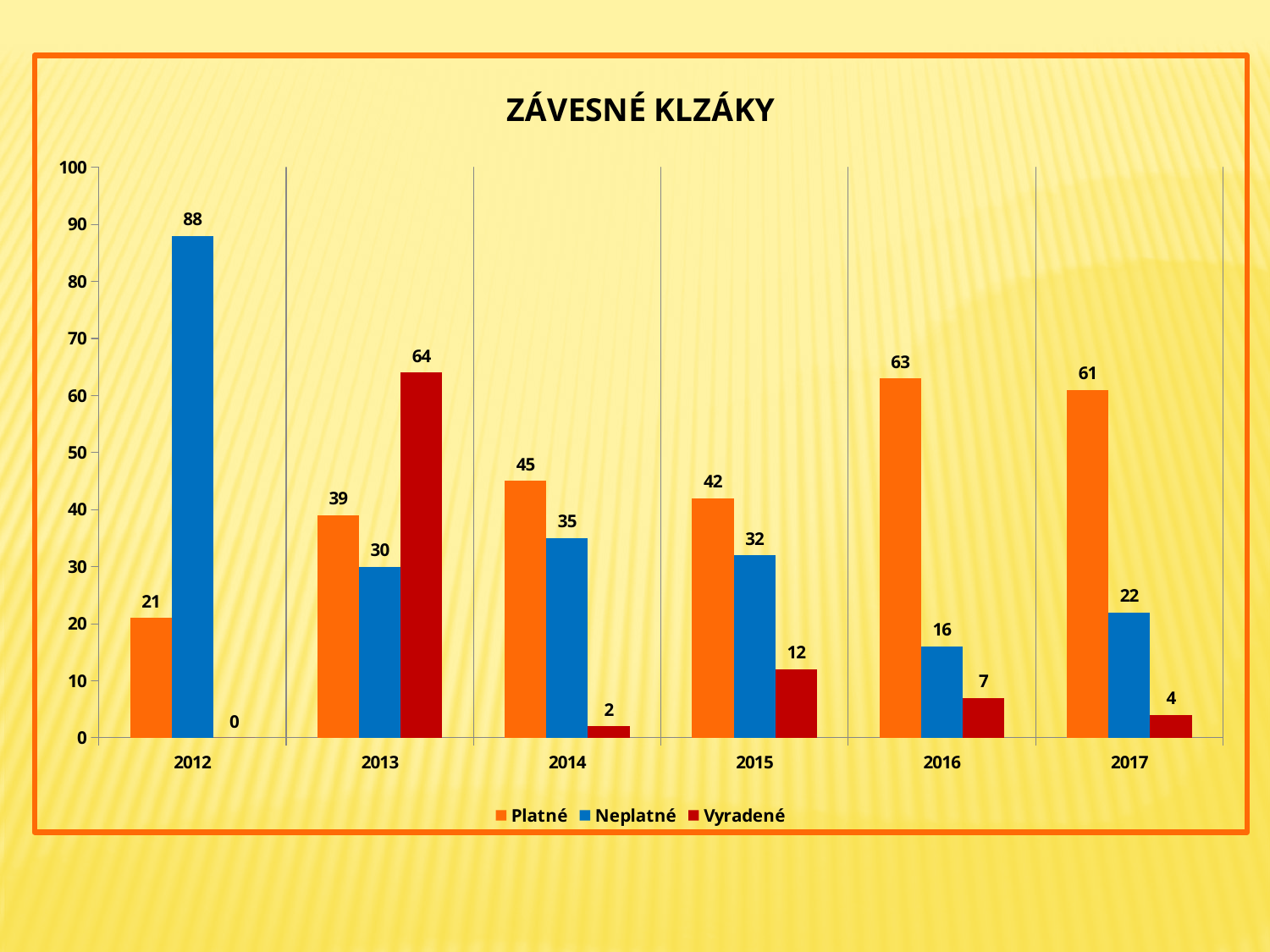
What is the value for Vyradené in 2013? 64 How many years are shown on the x axis? 6 What is the difference between the Platné and Neplatné values in 2017? 39 What kind of chart is shown? Bar chart What is the value for Platné in 2016? 63 Does the Neplatné value rise or fall from 2012 to 2013? Fall In which year is the Vyradené value lowest? 2012 What is the title of the chart? ZÁVESNÉ KLZÁKY Which is larger in 2014, Platné or Neplatné? Platné In which year is the Platné value highest? 2016 What is the value for Neplatné in 2012? 88 How many series does the legend list? 3